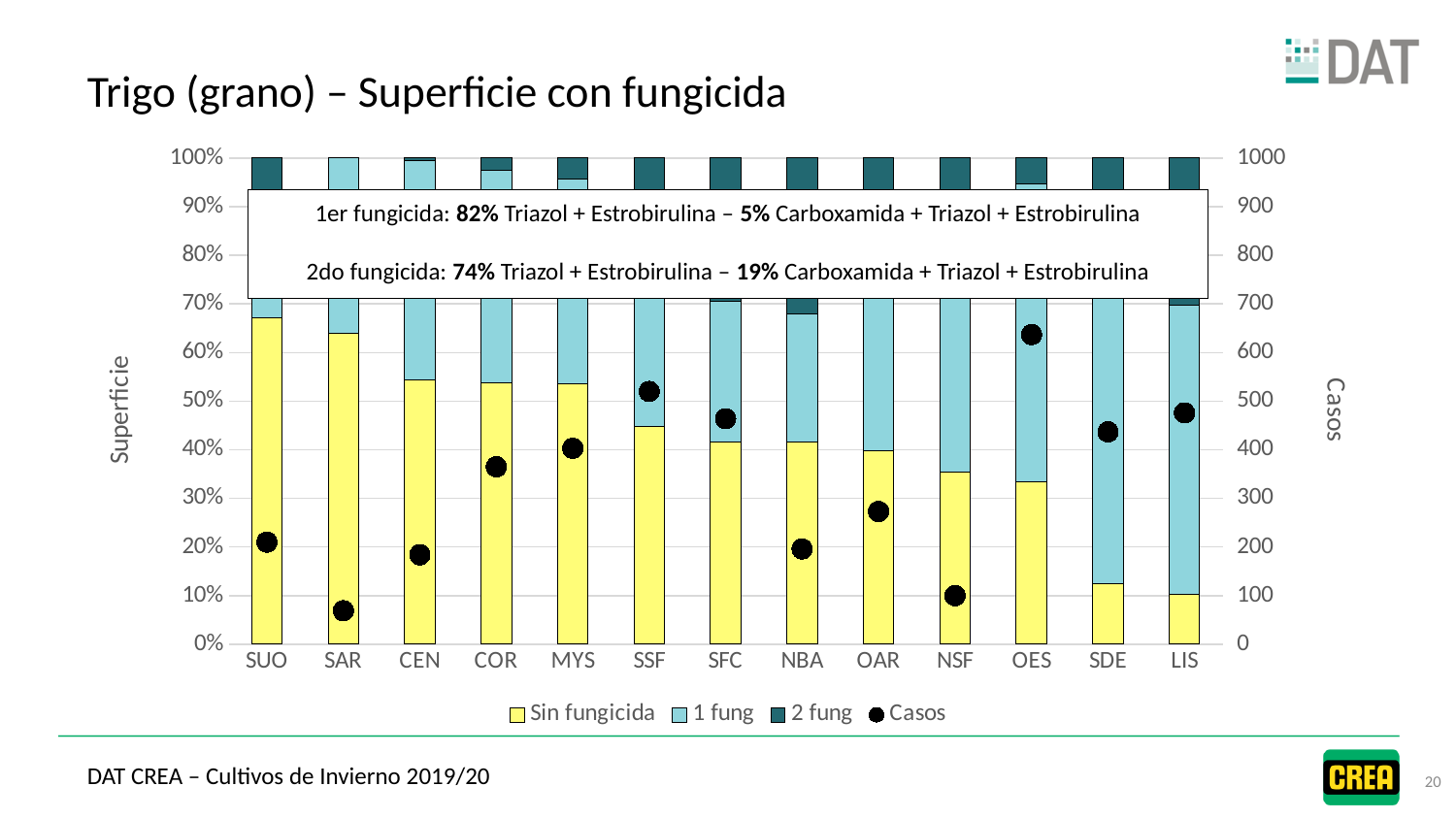
What is the title of the chart? Trigo (grano) – Superficie con fungicida Is the Sin fungicida share for SDE greater or less than 20%? less Is the Sin fungicida share for SUO greater or less than 60%? greater How many series does the legend list? 4 Which category has the highest number of Casos? OES What is the label of the right-hand vertical axis? Casos What kind of chart is shown on the slide? Stacked bar chart with points for Casos Is the number of Casos for NSF greater or less than 200? less Which category has the lowest number of Casos? SAR How many categories are shown on the x axis? 13 Which has more Casos, SSF or NBA? SSF